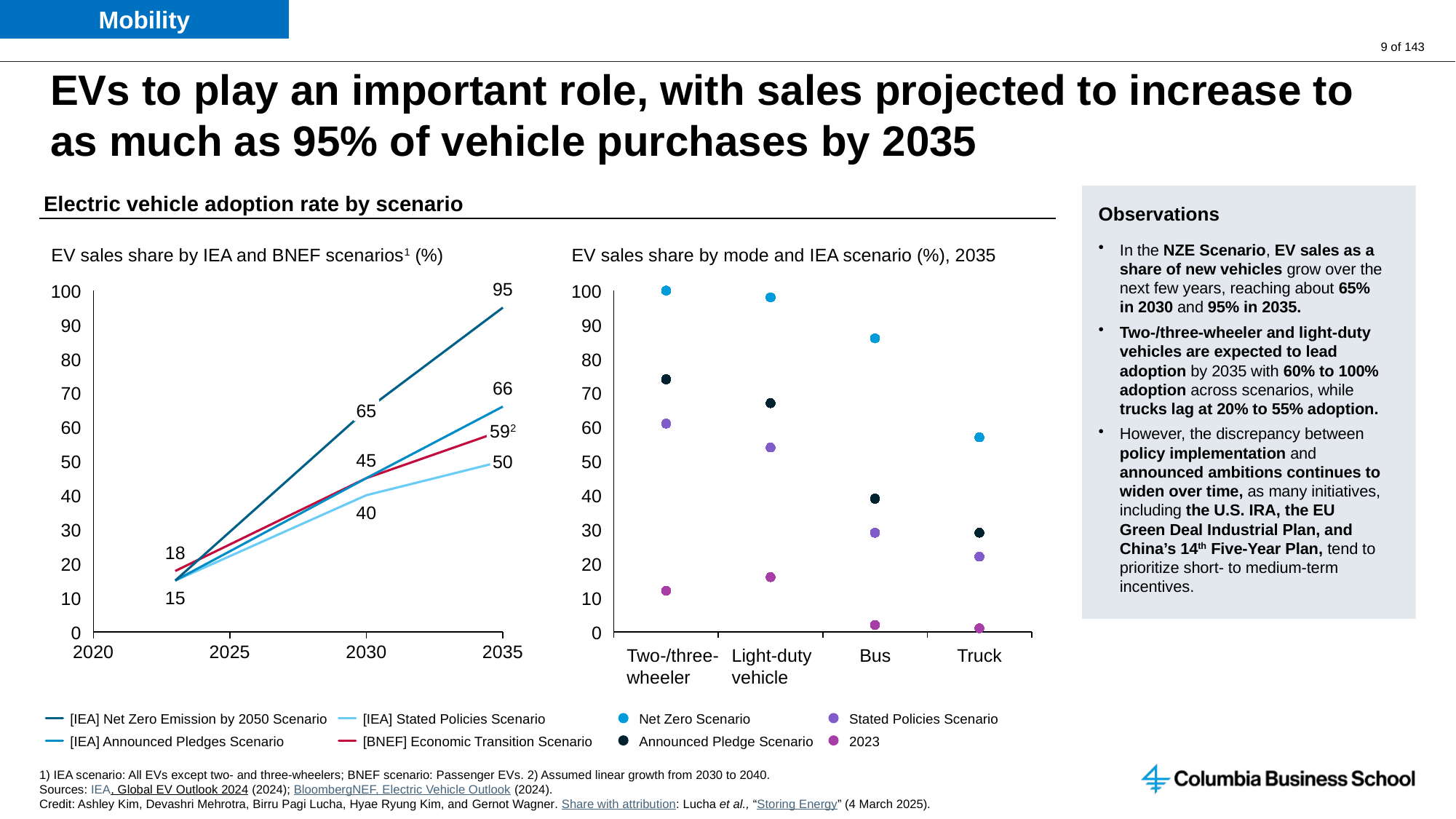
In the chart 'EV sales share by IEA and BNEF scenarios (%)', what is the difference between the [IEA] Net Zero Emission by 2050 Scenario and the [IEA] Stated Policies Scenario in 2035? 45 In the chart 'EV sales share by IEA and BNEF scenarios (%)', do the values for the [IEA] Net Zero Emission by 2050 Scenario rise or fall from 2023 to 2035? Rise In the chart 'EV sales share by IEA and BNEF scenarios (%)', what is the value for the [IEA] Net Zero Emission by 2050 Scenario in 2035? 95 In the chart 'EV sales share by IEA and BNEF scenarios (%)', what is the value for the [IEA] Net Zero Emission by 2050 Scenario in 2030? 65 What kind of chart is 'EV sales share by IEA and BNEF scenarios (%)'? Line chart In the chart 'EV sales share by mode and IEA scenario (%), 2035', is the 2023 value for Two-/three-wheeler greater or less than 20? less In the chart 'EV sales share by mode and IEA scenario (%), 2035', is the Net Zero Scenario value for Truck greater or less than 50? greater In the chart 'EV sales share by IEA and BNEF scenarios (%)', which scenario has the highest value in 2035? [IEA] Net Zero Emission by 2050 Scenario How many vehicle modes are shown on the x axis of the chart 'EV sales share by mode and IEA scenario (%), 2035'? 4 In the chart 'EV sales share by mode and IEA scenario (%), 2035', which mode has the lowest Net Zero Scenario value? Truck How many series does the legend of the chart 'EV sales share by IEA and BNEF scenarios (%)' list? 4 In the chart 'EV sales share by IEA and BNEF scenarios (%)', what is the value for the [IEA] Stated Policies Scenario in 2035? 50